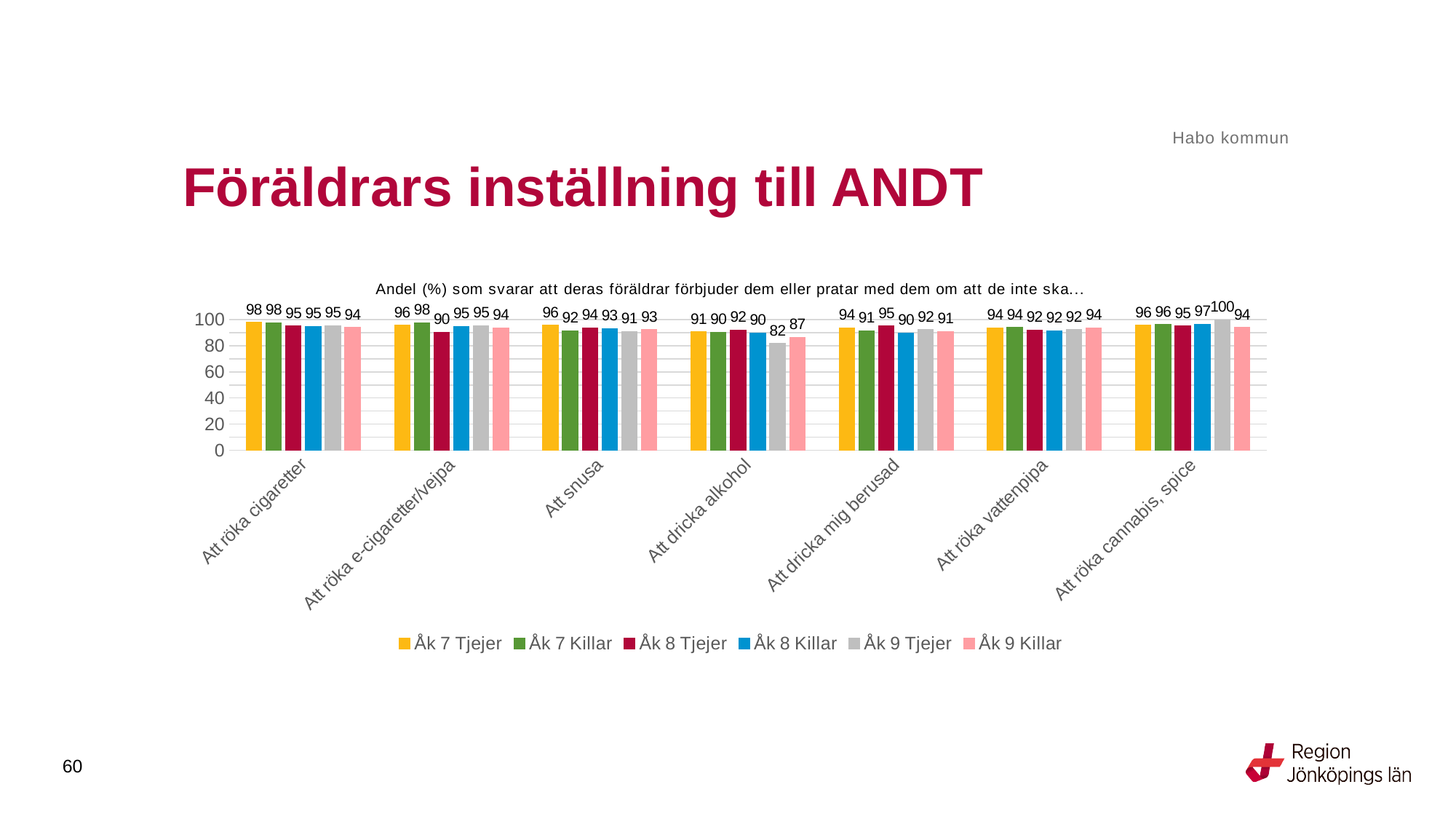
What is the value for Åk 9 Tjejer in the category "Att dricka alkohol"? 82 Which series has the highest value in the category "Att röka cannabis, spice"? Åk 9 Tjejer What is the value for Åk 7 Tjejer in the category "Att snusa"? 96 How many categories are shown on the x axis of the chart? 7 What is the value for Åk 9 Tjejer in the category "Att röka cannabis, spice"? 100 How many series does the legend list? 6 What is the difference between the Åk 9 Killar and Åk 9 Tjejer values in the category "Att dricka alkohol"? 5 Which series is shown in yellow in the chart legend? Åk 7 Tjejer What kind of chart is shown on the slide? Bar chart Which series has the lowest value in the category "Att dricka alkohol"? Åk 9 Tjejer In the category "Att röka e-cigaretter/vejpa", which is larger: the value for Åk 7 Killar or Åk 8 Tjejer? Åk 7 Killar What is the value for Åk 8 Tjejer in the category "Att röka e-cigaretter/vejpa"? 90